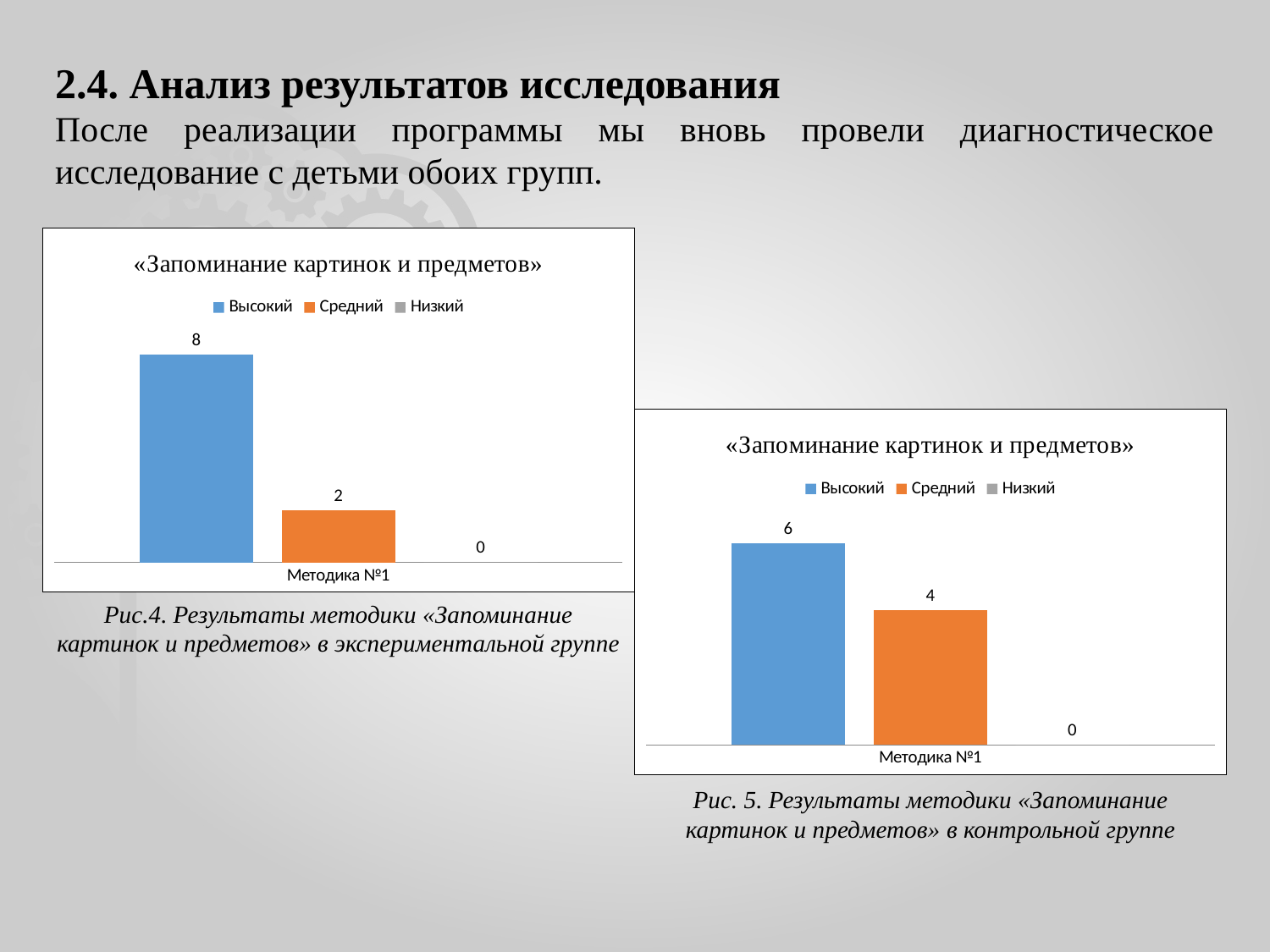
Which is larger: Высокий in the left chart (Рис.4) or Высокий in the right chart (Рис. 5)? Высокий in the left chart (Рис.4) In the right chart (Рис. 5, control group), which series has the lowest value? Низкий In the left chart (Рис.4, experimental group), what is the difference between Высокий and Средний? 6 In the left chart (Рис.4, experimental group), what is the value for Средний? 2 How many series does the legend of the left chart (Рис.4, experimental group) list? 3 In the right chart (Рис. 5, control group), what is the value for Низкий? 0 In the right chart (Рис. 5, control group), what is the difference between Высокий and Средний? 2 What type of chart is the right chart (Рис. 5, control group)? Bar chart In the right chart (Рис. 5, control group), what is the value for Высокий? 6 In the left chart (Рис.4, experimental group), what is the value for Высокий? 8 In the left chart (Рис.4, experimental group), which series has the highest value? Высокий In the right chart (Рис. 5, control group), what is the value for Средний? 4